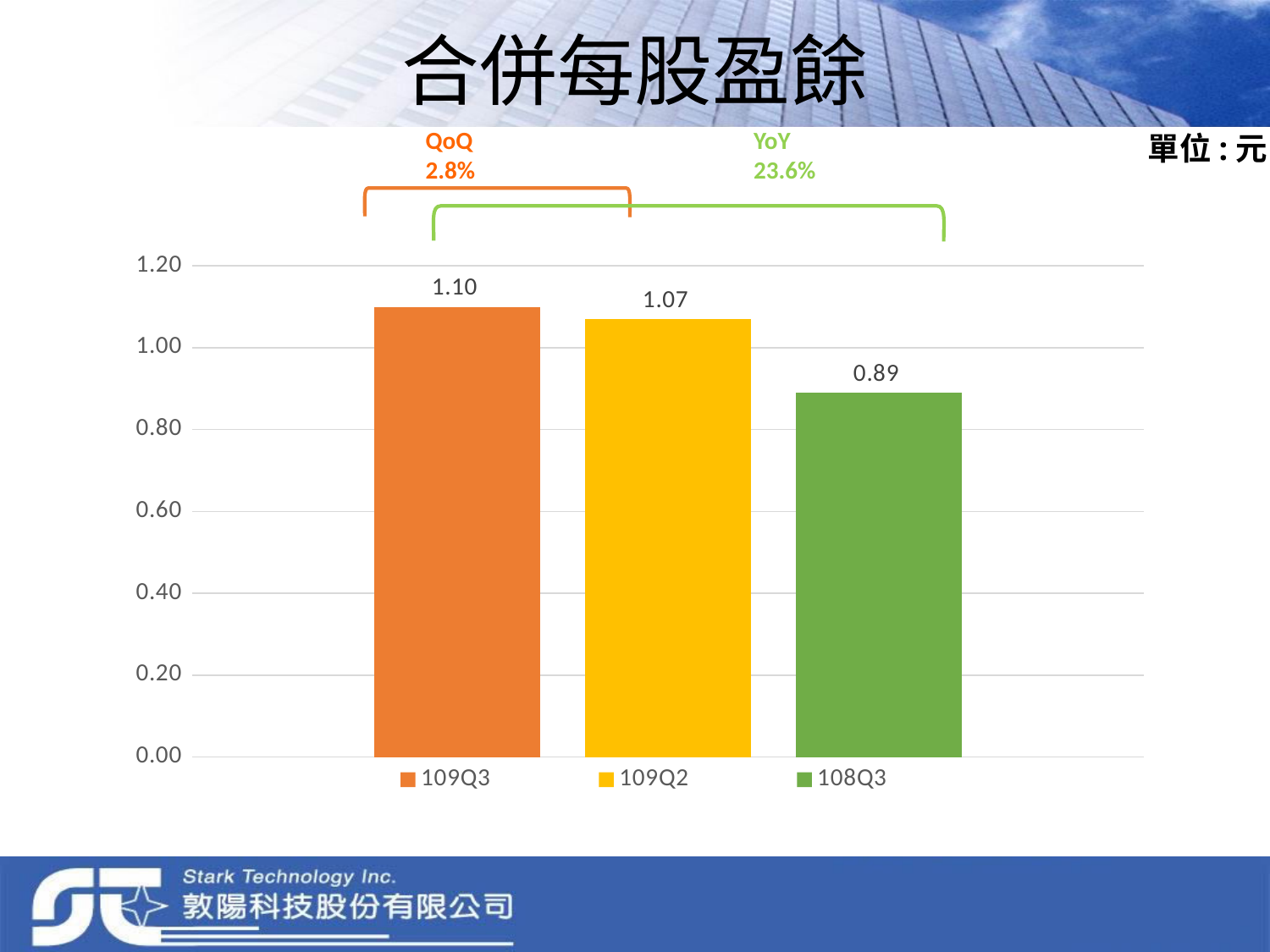
What is the value for 109Q2? 1.07 Which period has the lowest value? 108Q3 Which period has the highest value? 109Q3 What QoQ percentage change is annotated above the chart? 2.8% What is the value for 108Q3? 0.89 What kind of chart is shown on the slide? bar chart Is the value for 108Q3 greater or less than 1.00? less What is the difference between the values for 109Q3 and 109Q2? 0.03 What is the difference between the values for 109Q3 and 108Q3? 0.21 Which is larger, the value for 109Q2 or the value for 108Q3? 109Q2 What is the value for 109Q3? 1.10 How many bars are shown in the chart? 3